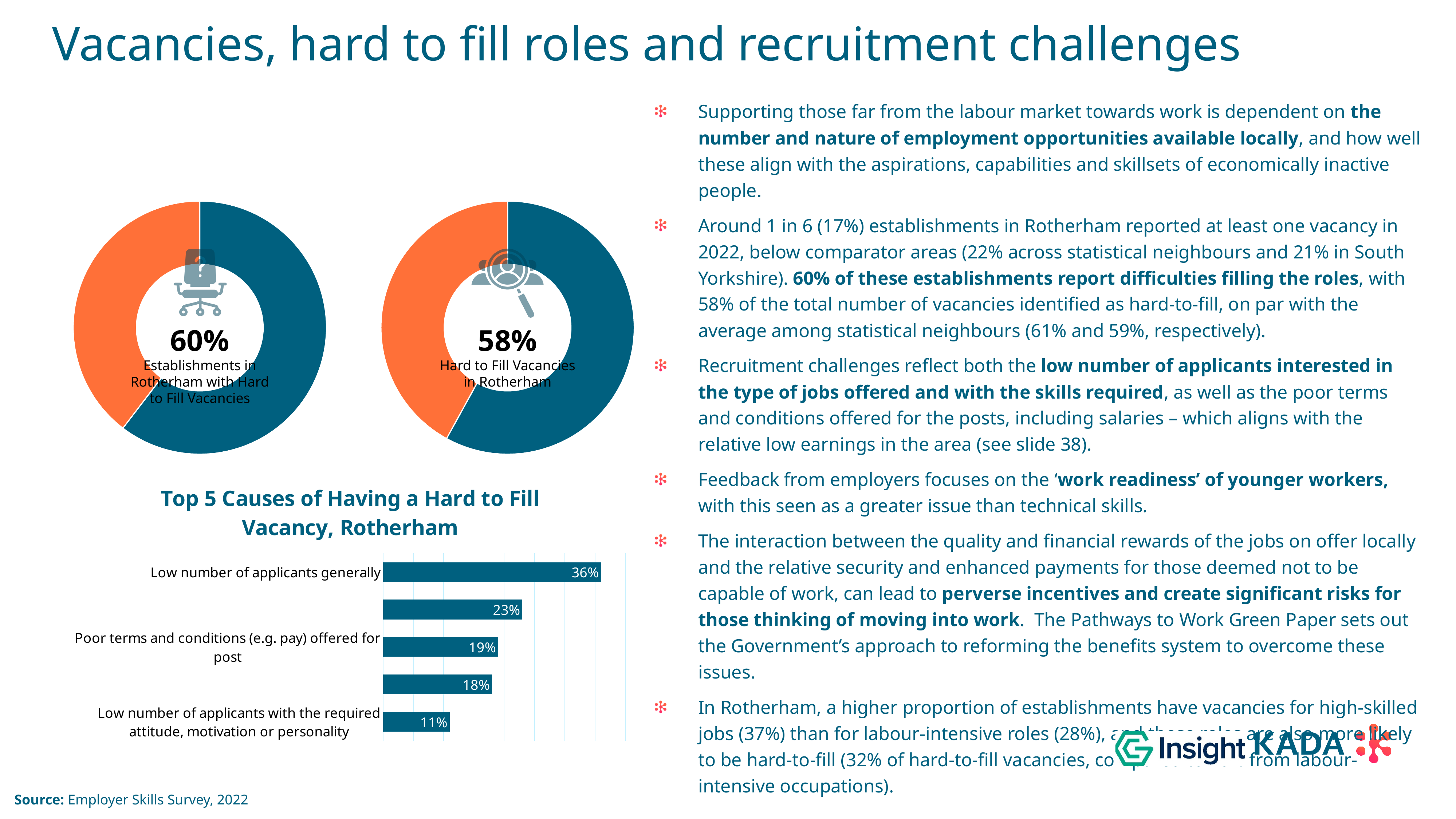
In the 'Top 5 Causes of Having a Hard to Fill Vacancy, Rotherham' chart, which cause has the lowest value? Low number of applicants with the required attitude, motivation or personality How many bars are shown in the 'Top 5 Causes of Having a Hard to Fill Vacancy, Rotherham' chart? 5 In the 'Top 5 Causes of Having a Hard to Fill Vacancy, Rotherham' chart, which cause has the highest value? Low number of applicants generally In the 'Top 5 Causes of Having a Hard to Fill Vacancy, Rotherham' chart, what is the value for 'Low number of applicants with the required attitude, motivation or personality'? 11% In the left donut chart, what percentage of establishments in Rotherham have hard to fill vacancies? 60% What is the title of the bar chart at the bottom left of the slide? Top 5 Causes of Having a Hard to Fill Vacancy, Rotherham In the 'Top 5 Causes of Having a Hard to Fill Vacancy, Rotherham' chart, what is the difference between 'Low number of applicants generally' and 'Poor terms and conditions (e.g. pay) offered for post'? 17% What kind of chart is the 'Top 5 Causes of Having a Hard to Fill Vacancy, Rotherham' chart? Bar chart In the 'Top 5 Causes of Having a Hard to Fill Vacancy, Rotherham' chart, which is larger: 'Poor terms and conditions (e.g. pay) offered for post' or 'Low number of applicants with the required attitude, motivation or personality'? Poor terms and conditions (e.g. pay) offered for post In the right donut chart, what percentage of vacancies in Rotherham are hard to fill? 58% In the 'Top 5 Causes of Having a Hard to Fill Vacancy, Rotherham' chart, what is the value for 'Low number of applicants generally'? 36% In the 'Top 5 Causes of Having a Hard to Fill Vacancy, Rotherham' chart, what is the value for 'Poor terms and conditions (e.g. pay) offered for post'? 19%